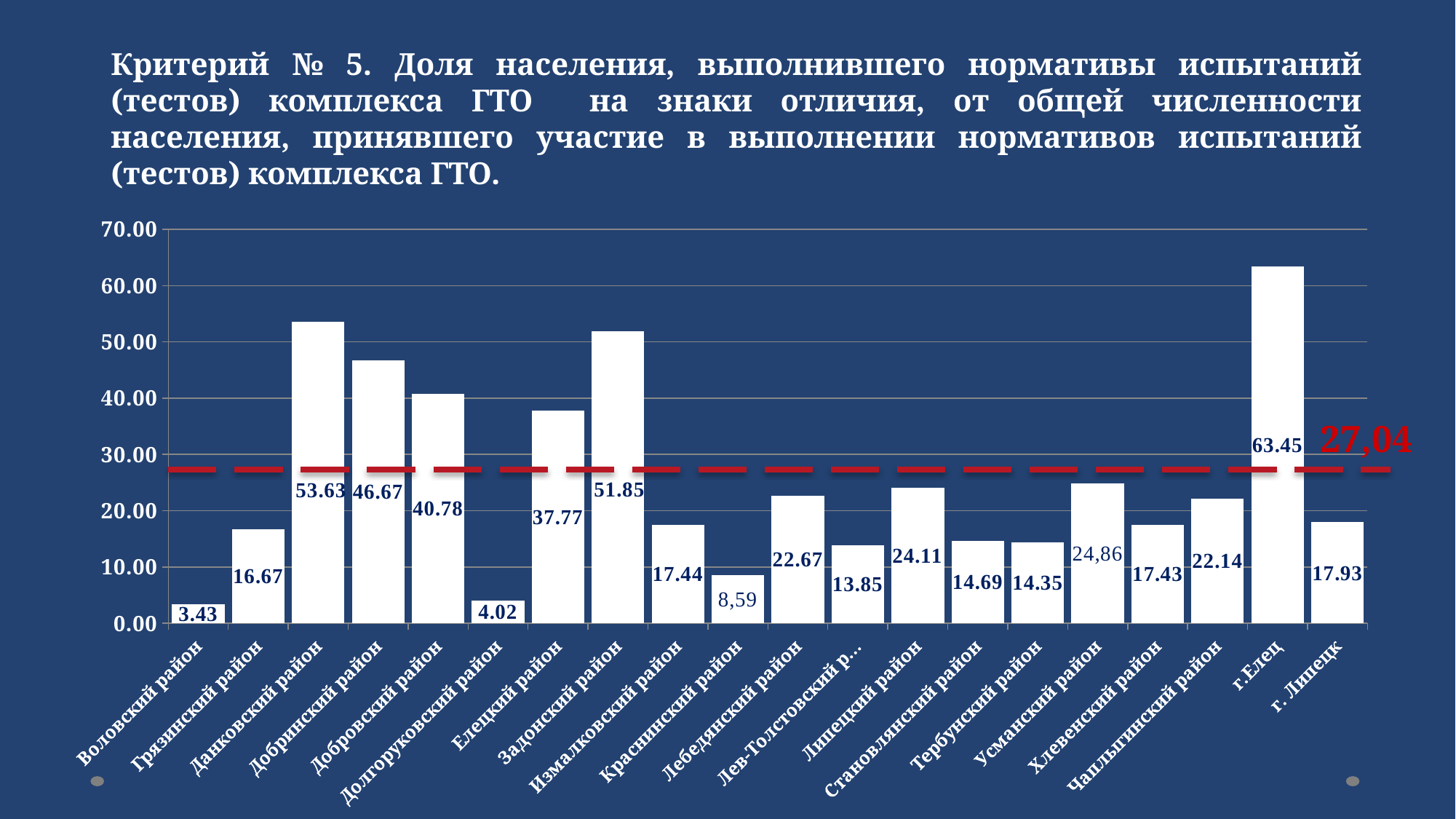
What value is labelled on the red dashed horizontal line? 27,04 Is the value for Задонский район greater or less than 50? greater Which is larger, the value for Елецкий район or Добровский район? Добровский район What is the value for Краснинский район? 8,59 What is the difference between the values for Добринский район and Добровский район? 5.89 What is the value for г. Липецк? 17.93 What type of chart is shown on the slide? bar chart Which category has the highest value? г.Елец Which category has the lowest value? Воловский район How many districts/cities are shown on the x axis of the chart? 20 What is the value for Данковский район? 53.63 What is the difference between the values for г.Елец and Данковский район? 9.82